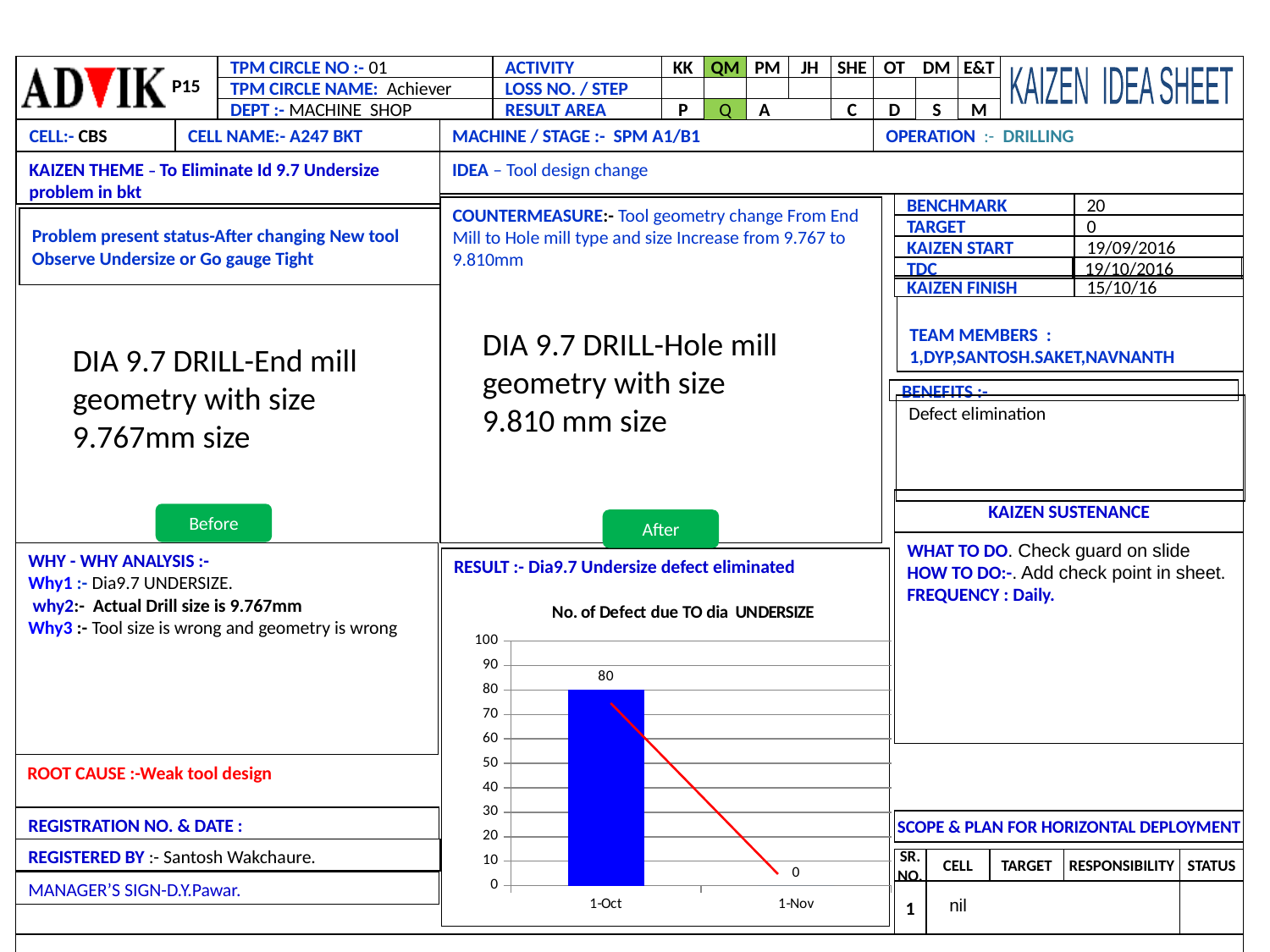
How many categories are shown on the x axis of the chart? 2 Which category has the highest number of defects? 1-Oct Which has a larger value, 1-Oct or 1-Nov? 1-Oct Do the values rise or fall from 1-Oct to 1-Nov? fall What type of chart is used to show the number of defects due to dia undersize? bar chart Is the value for 1-Oct greater or less than 50? greater Which category has the lowest number of defects? 1-Nov What is the number of defects shown for 1-Nov? 0 What is the maximum value shown on the chart's y axis? 100 What is the number of defects shown for 1-Oct? 80 What is the difference between the defect counts for 1-Oct and 1-Nov? 80 What is the title of the chart on the slide? No. of Defect due TO dia UNDERSIZE